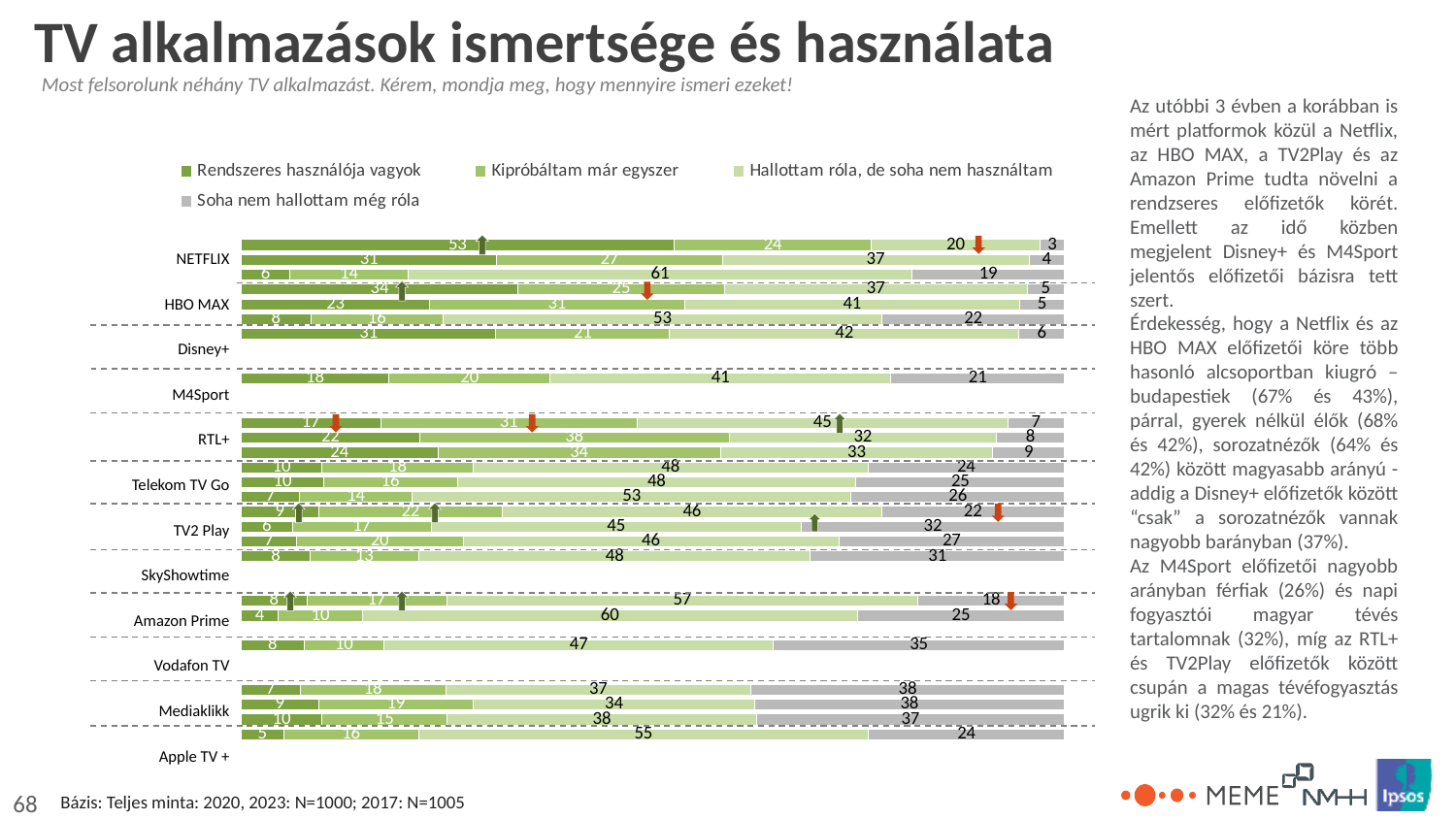
What is the title of the slide's chart? TV alkalmazások ismertsége és használata In the bottommost bar of the chart (Apple TV +), what is the value for 'Rendszeres használója vagyok'? 5 In the topmost NETFLIX bar, what is the value for 'Rendszeres használója vagyok'? 53 How many series does the legend list? 4 In the bottommost bar of the chart (Apple TV +), what is the value for 'Hallottam róla, de soha nem használtam'? 55 In the topmost NETFLIX bar, what is the value for 'Kipróbáltam már egyszer'? 24 In the topmost NETFLIX bar, what is the value for 'Soha nem hallottam még róla'? 3 In the topmost NETFLIX bar, what is the difference between 'Rendszeres használója vagyok' (53) and 'Kipróbáltam már egyszer' (24)? 29 Which legend entry is shown in grey? Soha nem hallottam még róla In the topmost NETFLIX bar, which is larger: 'Rendszeres használója vagyok' or 'Hallottam róla, de soha nem használtam'? Rendszeres használója vagyok How many TV applications (categories) are listed on the chart? 12 What kind of chart is shown on the slide? bar chart